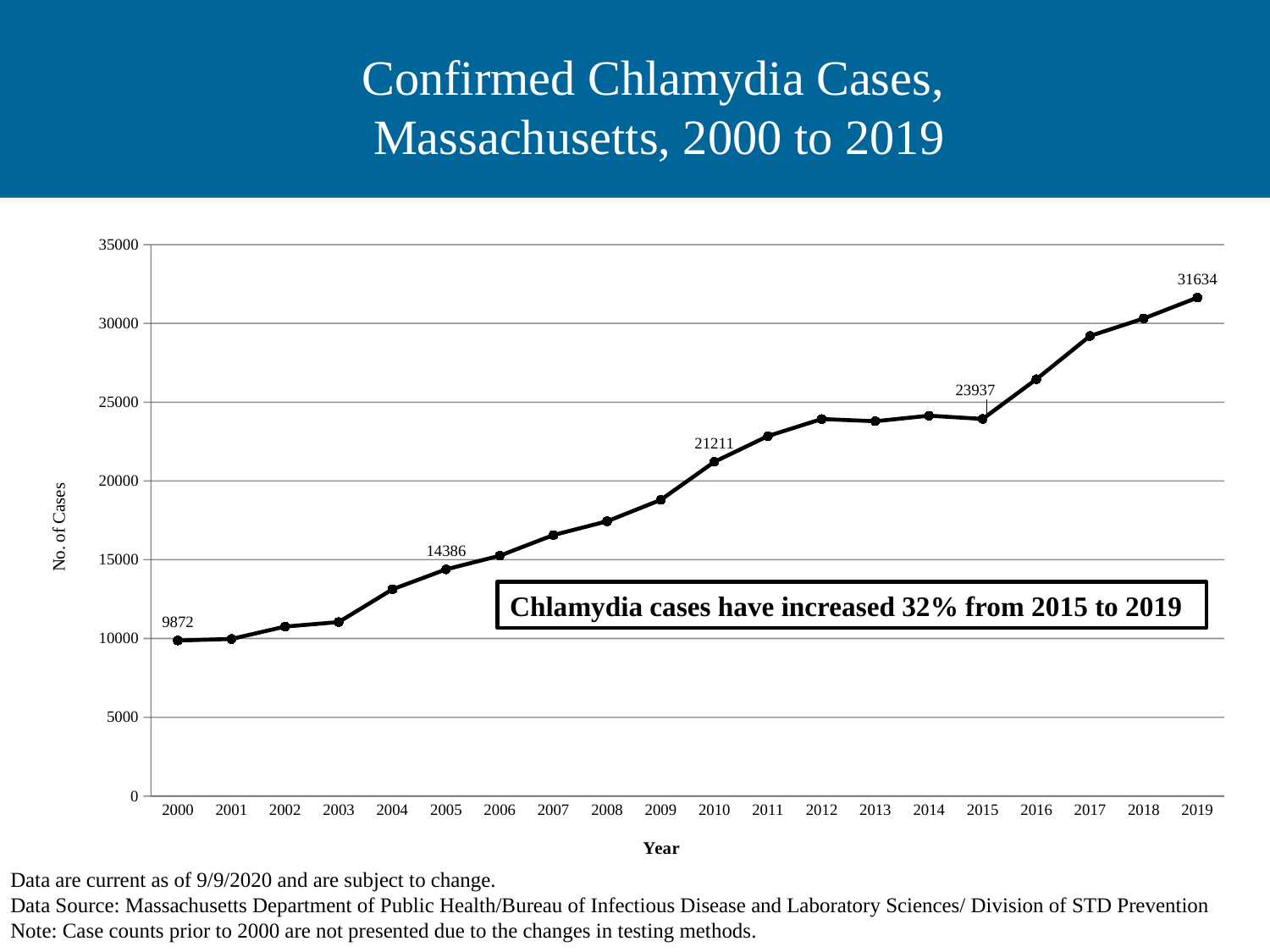
What is the difference in confirmed chlamydia cases between 2010 and 2005? 6825 What is the number of confirmed chlamydia cases in 2000? 9872 How many years are plotted on the chart? 20 What is the number of confirmed chlamydia cases in 2019? 31634 Is the number of confirmed chlamydia cases in 2004 greater or less than 15000? less What type of chart is shown on the slide? Line chart Which year has the lowest number of confirmed chlamydia cases? 2000 What is the number of confirmed chlamydia cases in 2005? 14386 What is the number of confirmed chlamydia cases in 2010? 21211 Is the number of confirmed chlamydia cases in 2017 greater or less than 25000? greater Which year has the highest number of confirmed chlamydia cases? 2019 How many more confirmed chlamydia cases were there in 2019 than in 2015? 7697